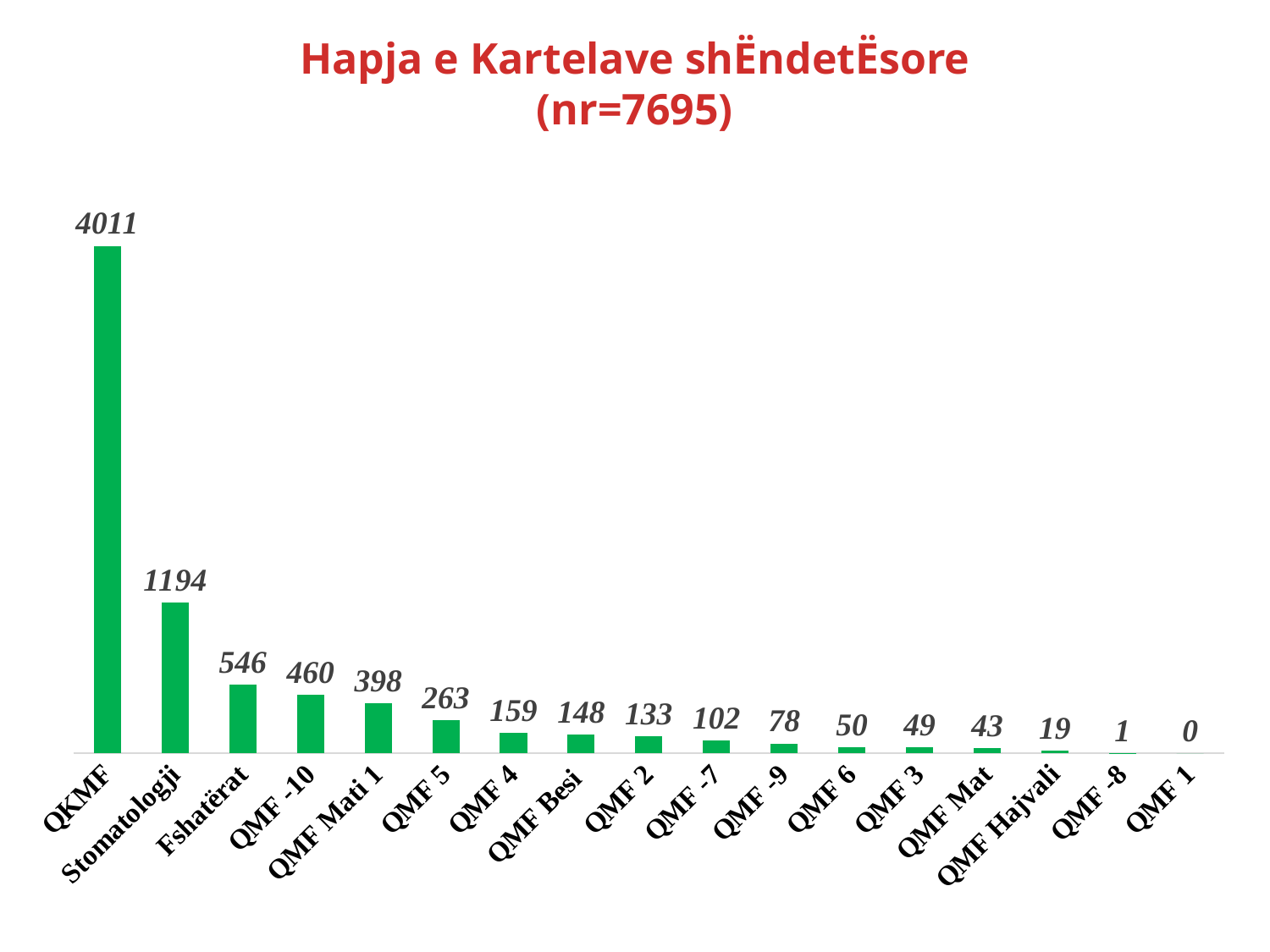
What is the value for QMF Hajvali? 19 What is the title of the chart? Hapja e Kartelave shËndetËsore (nr=7695) Which category has the highest value? QKMF Which is larger, the value for QMF 5 or the value for QMF 4? QMF 5 What is the difference between the values for Fshatërat and QMF -10? 86 Which category has the lowest value? QMF 1 What is the value for QMF Besi? 148 What is the difference between the values for QKMF and Stomatologji? 2817 What is the value for QKMF? 4011 What kind of chart is shown on the slide? Bar chart What is the value for Stomatologji? 1194 How many categories are shown on the x axis? 17